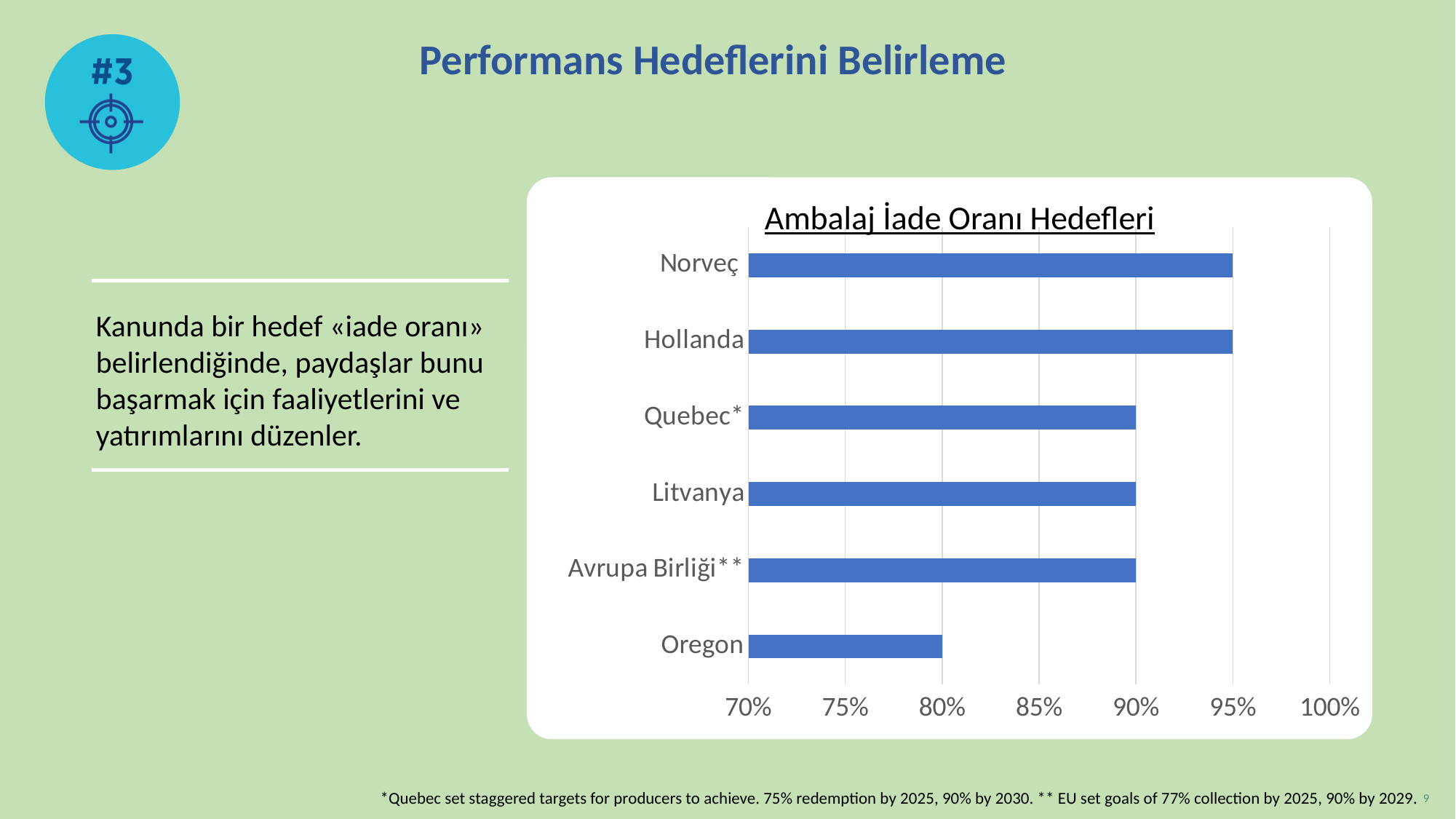
What is the value for Oregon? 80% Which category has the lowest value? Oregon What is the title of the chart? Ambalaj İade Oranı Hedefleri Is the value for Oregon greater or less than 85%? less What is the value for Hollanda? 95% Is the value for Quebec* greater or less than 85%? greater Which is larger, the value for Norveç or the value for Oregon? Norveç How many categories are shown in the chart? 6 What is the difference between the value for Norveç and the value for Oregon? 15% What is the value for Norveç? 95% What kind of chart is shown on the slide? bar chart What is the value for Litvanya? 90%